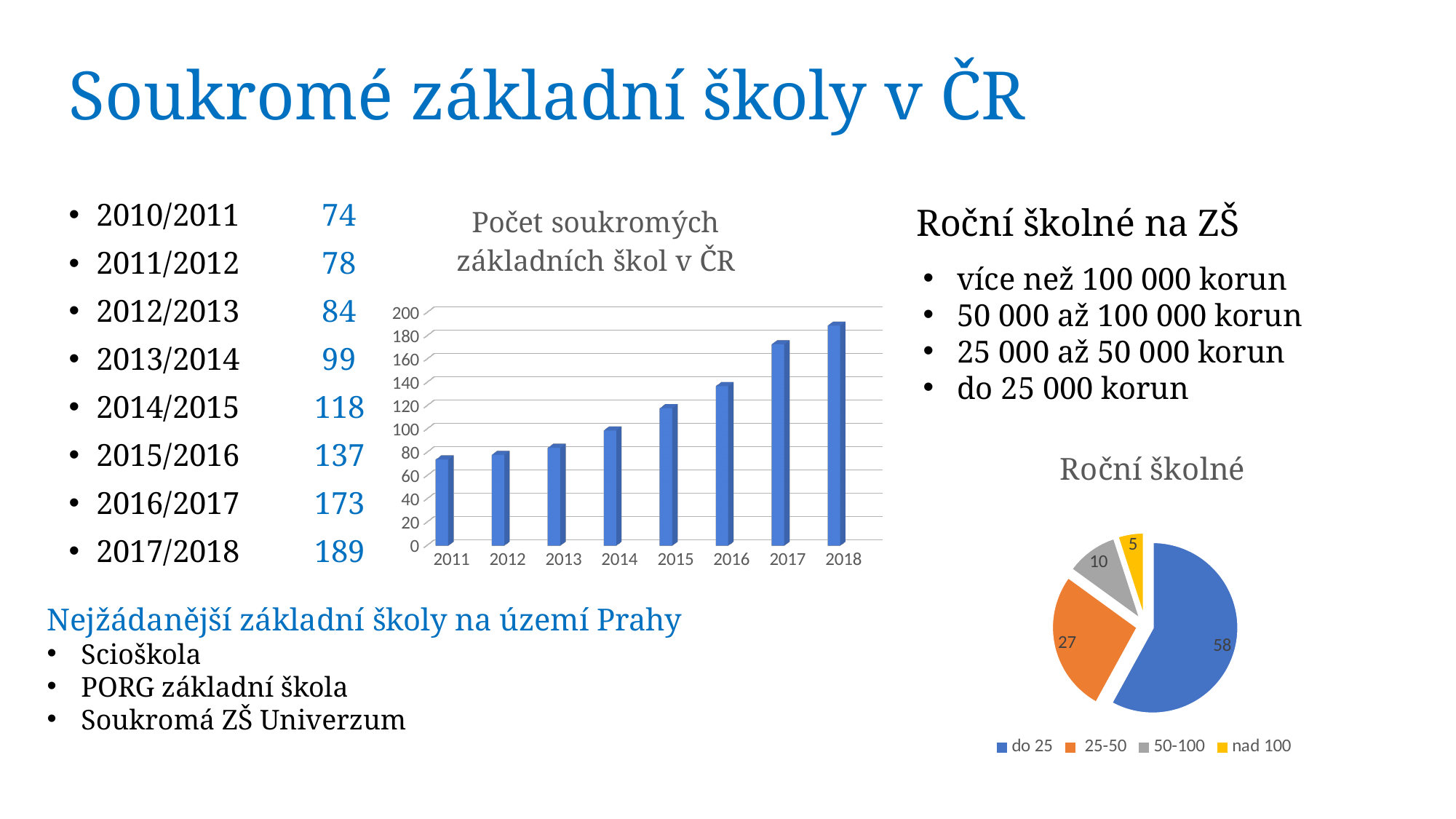
In the pie chart 'Roční školné', what is the difference between the values for 'do 25' and '25-50'? 31 In the pie chart 'Roční školné', which category has the smallest slice? nad 100 What kind of chart is 'Počet soukromých základních škol v ČR'? bar chart What kind of chart is 'Roční školné'? pie chart In the chart 'Počet soukromých základních škol v ČR', do the values rise or fall from 2011 to 2018? rise In the chart 'Počet soukromých základních škol v ČR', which year has the highest bar? 2018 In the chart 'Počet soukromých základních škol v ČR', is the value for 2011 greater or less than 80? less In the chart 'Počet soukromých základních škol v ČR', how many years are shown on the x axis? 8 In the chart 'Počet soukromých základních škol v ČR', is the value for 2018 greater or less than 180? greater In the chart 'Počet soukromých základních škol v ČR', which year has the lowest bar? 2011 In the chart 'Počet soukromých základních škol v ČR', is the value for 2017 greater or less than 160? greater In the pie chart 'Roční školné', what is the value for 'do 25'? 58